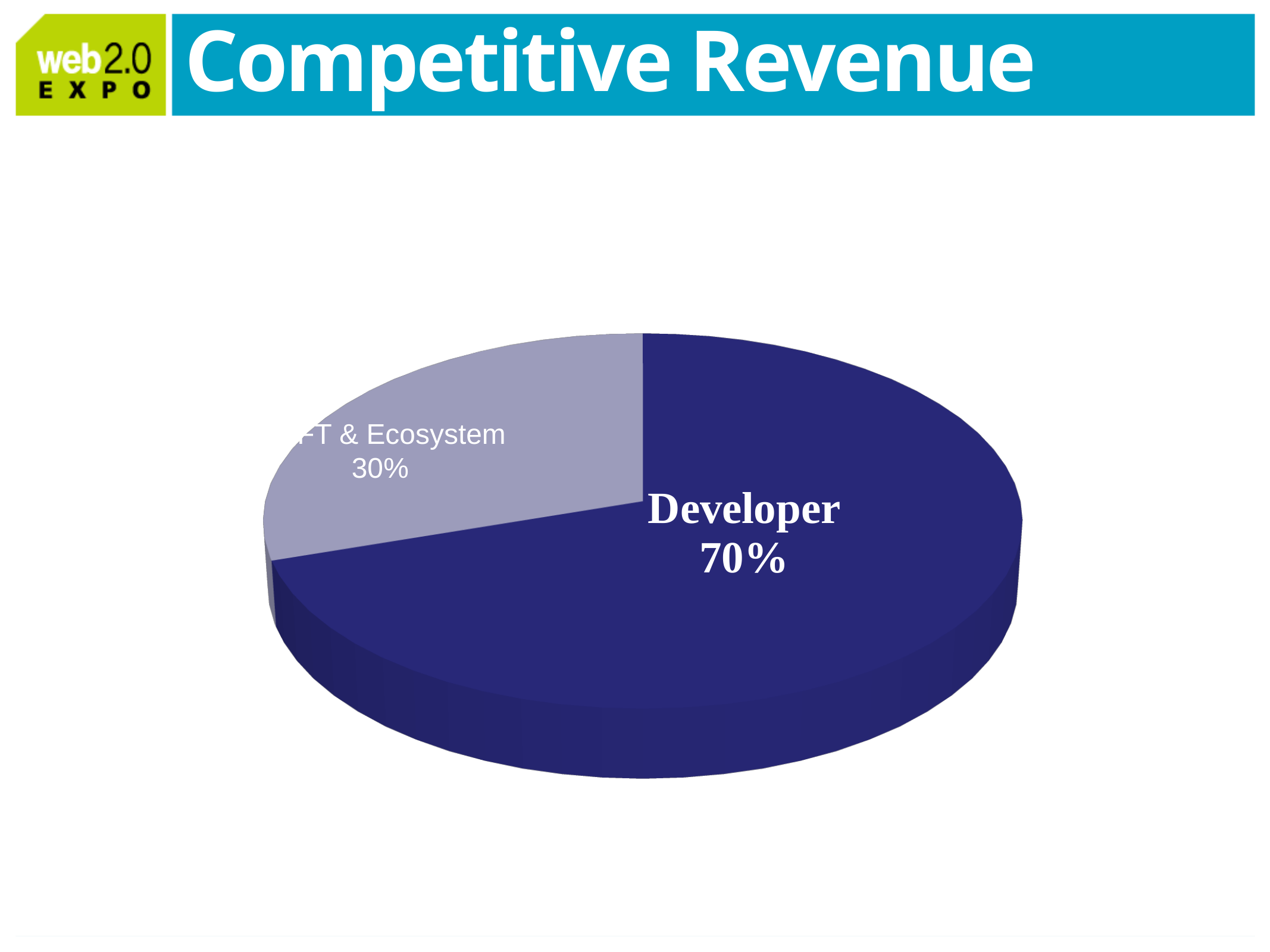
What percentage is shown for the lighter-coloured slice of the pie? 30% What is the title of the slide containing the pie chart? Competitive Revenue What kind of chart is shown on the slide? pie chart Which slice of the pie is the largest? Developer What is the difference in percentage points between the Developer slice and the lighter-coloured slice? 40 What share of the pie does the Developer slice represent? 70% What colour is the Developer slice of the pie? dark blue Is the Developer slice larger or smaller than the lighter-coloured slice? larger How many slices does the pie chart have? 2 Is the Developer share greater or less than 50%? greater